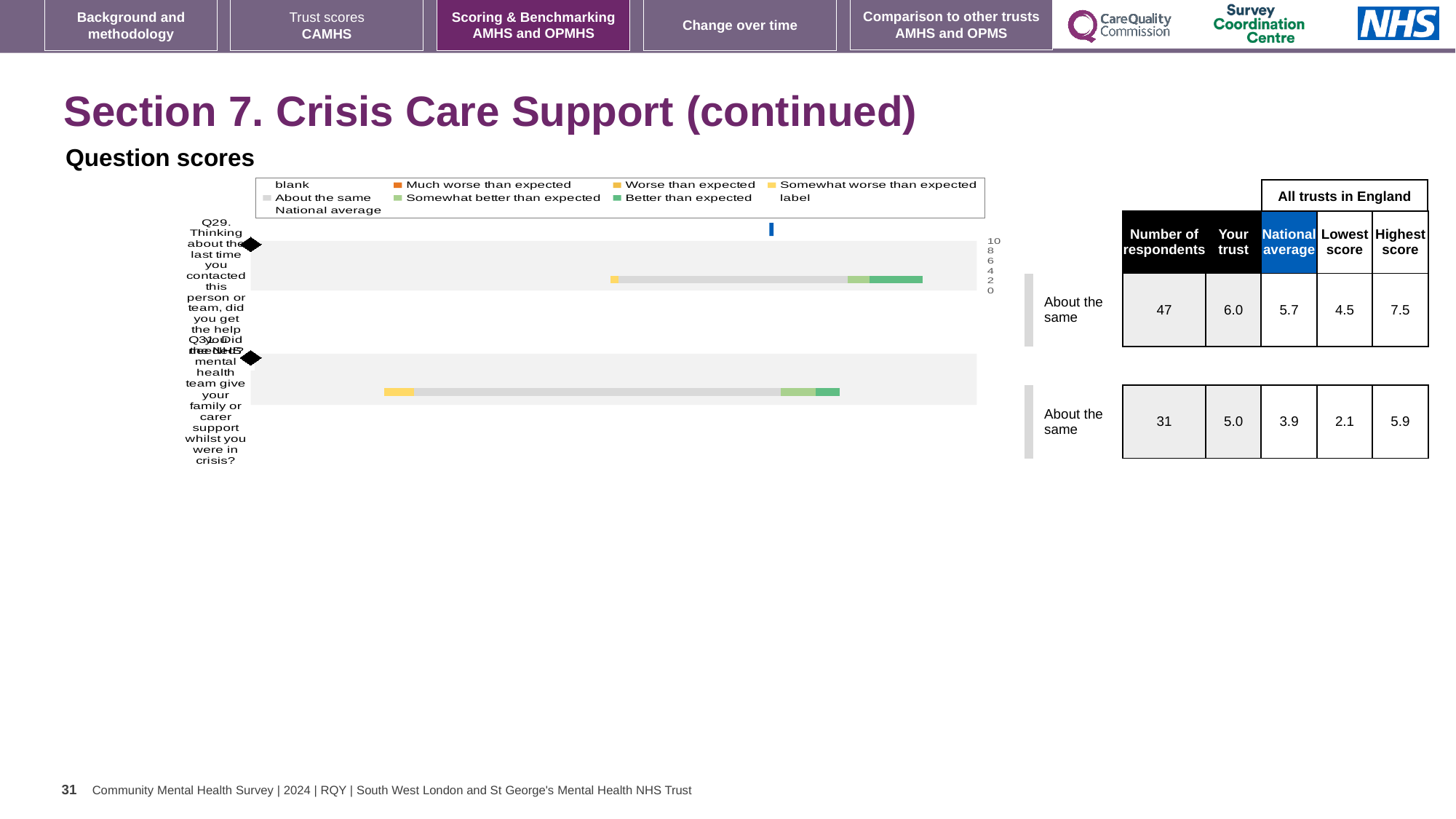
According to the table beside the chart, what is the highest score for Q29? 7.5 What is the difference between the 'Your trust' scores for Q29 and Q31 in the table beside the chart? 1.0 How many questions (bars) are plotted in the chart? 2 What kind of chart is shown under 'Question scores'? bar chart According to the table beside the chart, how many respondents answered Q31? 31 According to the table beside the chart, what is the 'Your trust' score for Q29? 6.0 According to the table beside the chart, what is the national average for Q31? 3.9 According to the table beside the chart, what is the 'Your trust' score for Q31? 5.0 Which two questions are plotted in the chart? Q29 and Q31 What colour does the legend use for 'Better than expected'? green What is the difference between the number of respondents for Q29 and Q31 in the table beside the chart? 16 Which question has the higher 'Your trust' score in the table beside the chart, Q29 or Q31? Q29